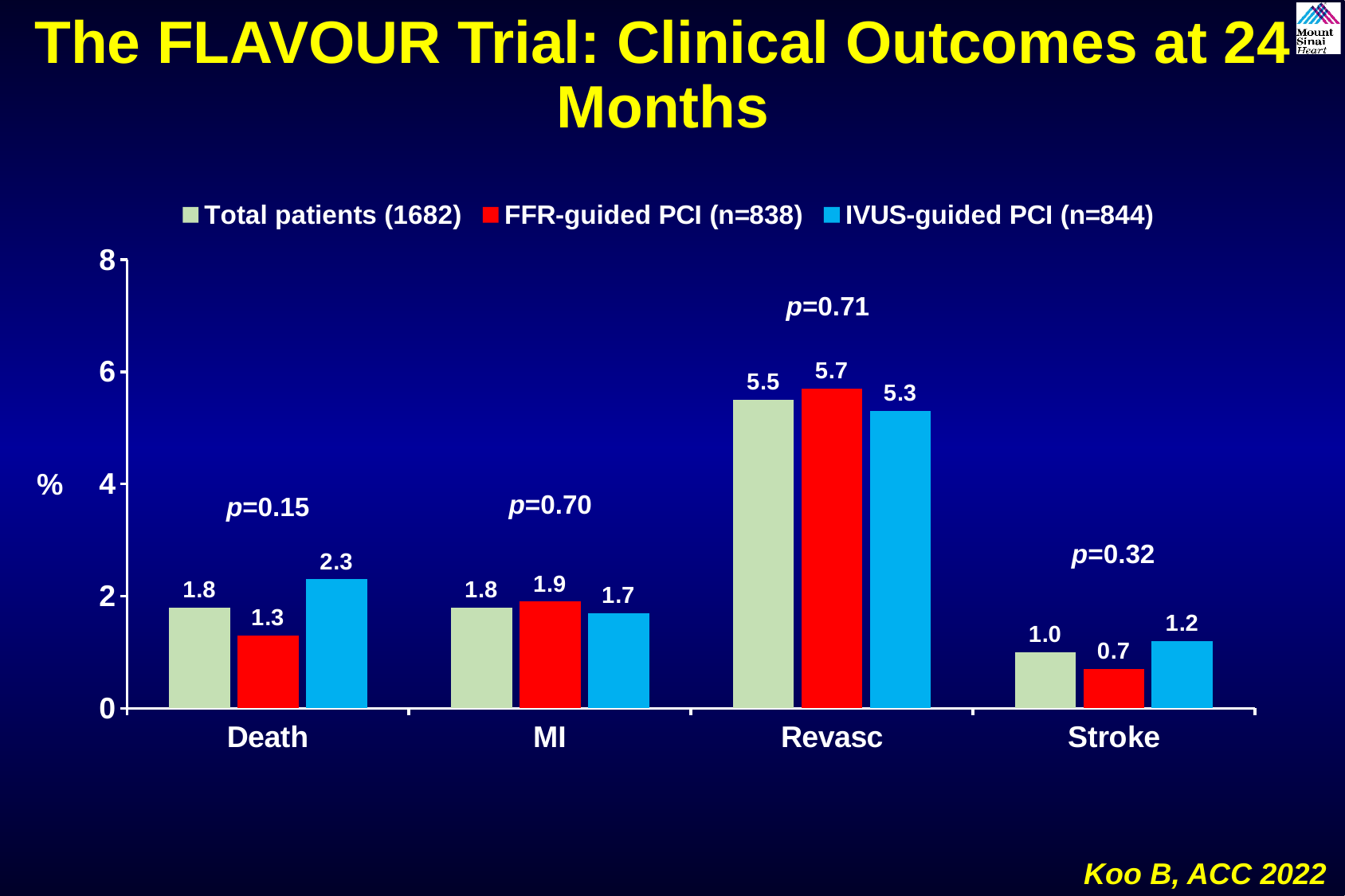
What is the value for Total patients (1682) in the Stroke category? 1.0 What kind of chart is shown on the slide? Bar chart What is the difference between the IVUS-guided PCI (n=844) and FFR-guided PCI (n=838) values in the Death category? 1.0 Is the value for FFR-guided PCI (n=838) in the Revasc category greater or less than 4? greater Which category has the lowest value for IVUS-guided PCI (n=844)? Stroke In the Stroke category, which is larger: the FFR-guided PCI (n=838) value or the IVUS-guided PCI (n=844) value? IVUS-guided PCI (n=844) How many outcome categories are shown on the x axis? 4 Which category has the highest value for FFR-guided PCI (n=838)? Revasc What p-value is shown above the Revasc category? p=0.71 How many series does the legend list? 3 What is the value for IVUS-guided PCI (n=844) in the Revasc category? 5.3 What is the value for FFR-guided PCI (n=838) in the Death category? 1.3